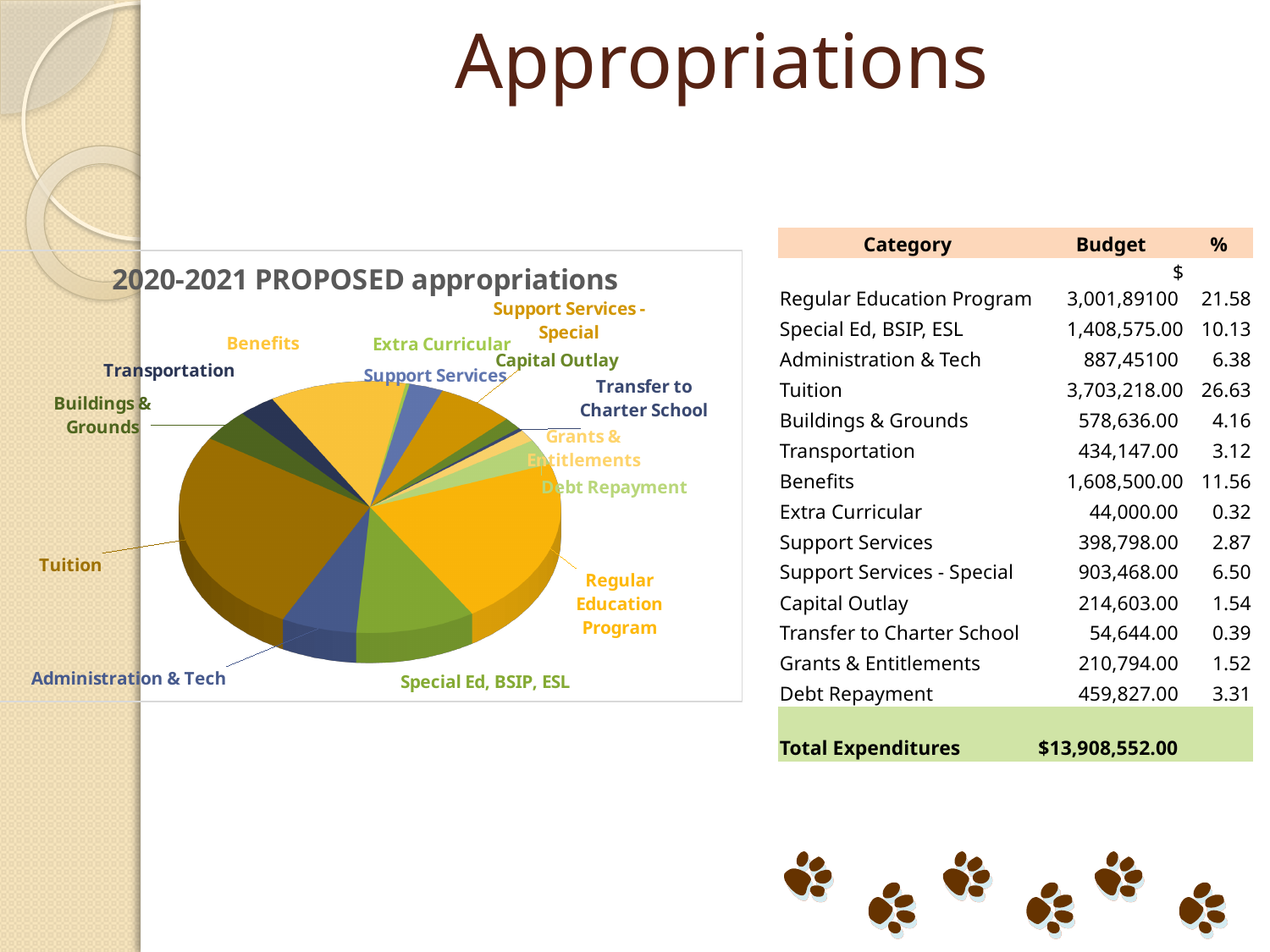
Which slice is larger, Benefits or Transportation? Benefits What is the budget for Special Ed, BSIP, ESL? 1,408,575.00 What is the budget for Benefits? 1,608,500.00 What percentage of the appropriations does Regular Education Program represent? 21.58 Which slice is larger, Special Ed, BSIP, ESL or Administration & Tech? Special Ed, BSIP, ESL What is the total of all expenditures shown? $13,908,552.00 Which slice is larger, Regular Education Program or Debt Repayment? Regular Education Program What kind of chart is shown on the slide? pie chart What is the title of the chart? 2020-2021 PROPOSED appropriations What percentage of the appropriations does Tuition represent? 26.63 How many categories does the pie chart show? 14 Which category has the largest slice of the pie? Tuition